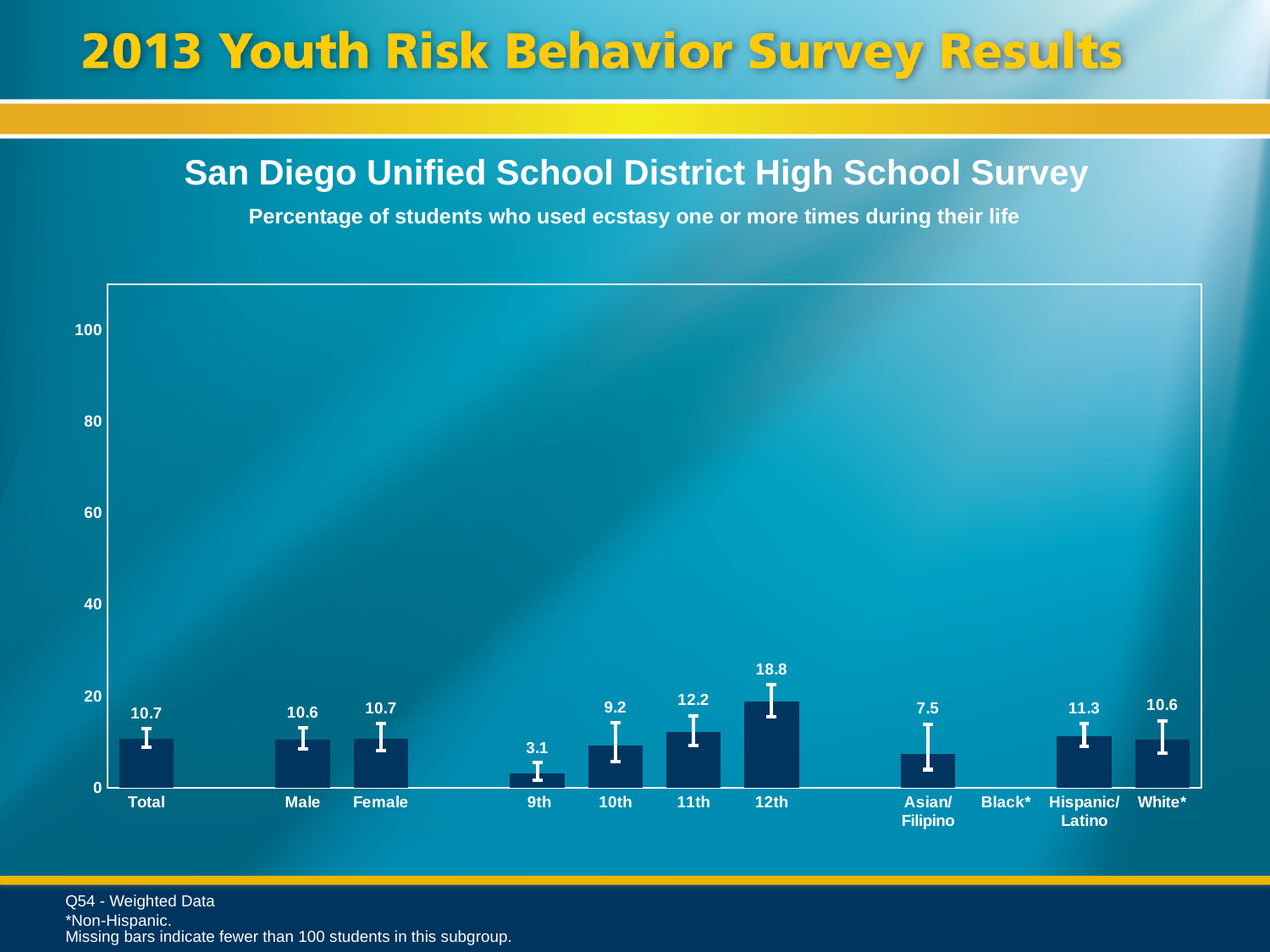
Is the value for 12th grade greater or less than 20? less Which category has the highest value? 12th What is the value for 12th grade? 18.8 How many categories are labeled on the x axis? 11 What is the value for Asian/Filipino? 7.5 Which category has no bar shown? Black* What is the value for Total? 10.7 What is the value for 9th grade? 3.1 What is the difference between the values for 12th and 9th grade? 15.7 Which is larger, the value for Hispanic/Latino or the value for White*? Hispanic/Latino What kind of chart is shown? bar chart Which category with a bar has the lowest value? 9th